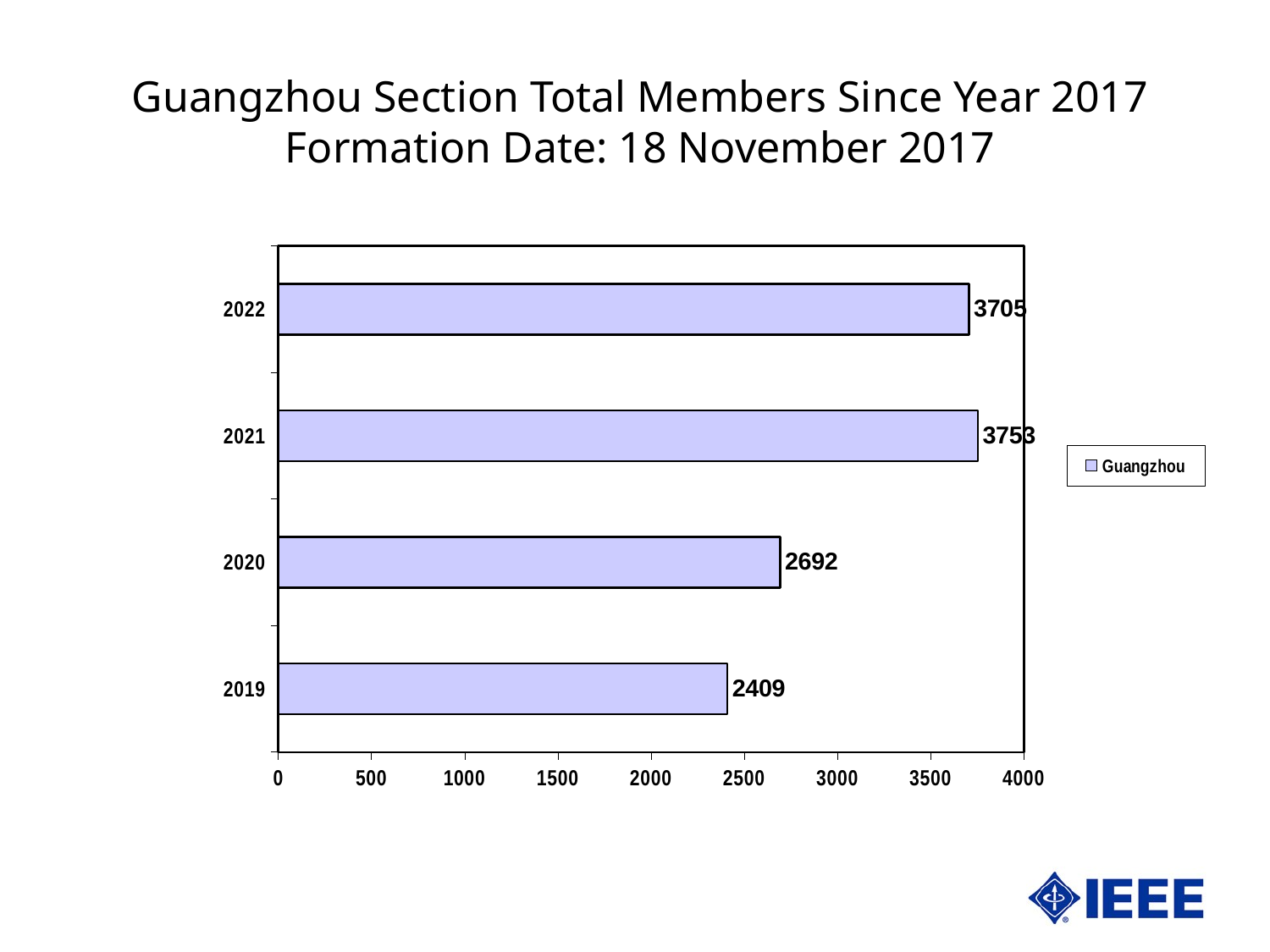
What kind of chart is shown on the slide? bar chart What is the value for 2022? 3705 Which year has the highest value? 2021 What is the difference between the values for 2021 and 2022? 48 What is the difference between the values for 2020 and 2019? 283 How many years are shown on the chart? 4 What series name does the legend show? Guangzhou Which year has the lowest value? 2019 What is the value for 2020? 2692 Which is larger, the value for 2020 or the value for 2022? 2022 Is the value for 2020 greater or less than 2500? greater What is the value for 2019? 2409